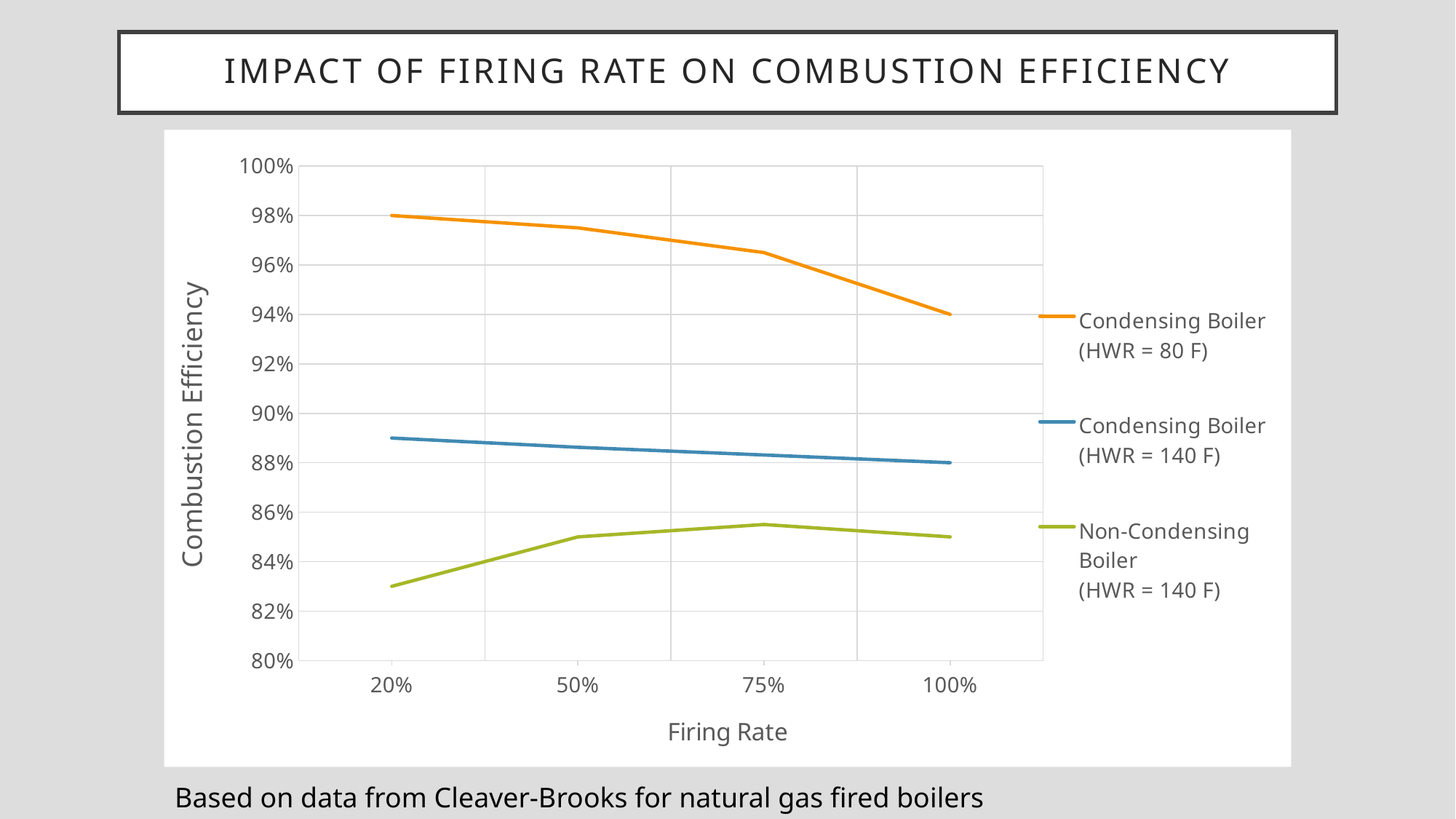
What is the combustion efficiency of the Condensing Boiler (HWR = 80 F) at a 100% firing rate? 94% What is the combustion efficiency of the Condensing Boiler (HWR = 80 F) at a 20% firing rate? 98% What is the title of the y axis? Combustion Efficiency Is the combustion efficiency of the Non-Condensing Boiler (HWR = 140 F) at a 20% firing rate greater or less than 84%? less How many series does the legend list? 3 What is the combustion efficiency of the Condensing Boiler (HWR = 140 F) at a 100% firing rate? 88% Which series has the lowest combustion efficiency at a 20% firing rate? Non-Condensing Boiler (HWR = 140 F) By how much does the combustion efficiency of the Condensing Boiler (HWR = 80 F) drop between the 20% and 100% firing rates? 4% How does the combustion efficiency of the Condensing Boiler (HWR = 80 F) change as the firing rate increases from 20% to 100%? It falls Which series has the highest combustion efficiency at a 100% firing rate? Condensing Boiler (HWR = 80 F) What kind of chart is shown on the slide? Line chart How many firing rate points are plotted along the x axis? 4